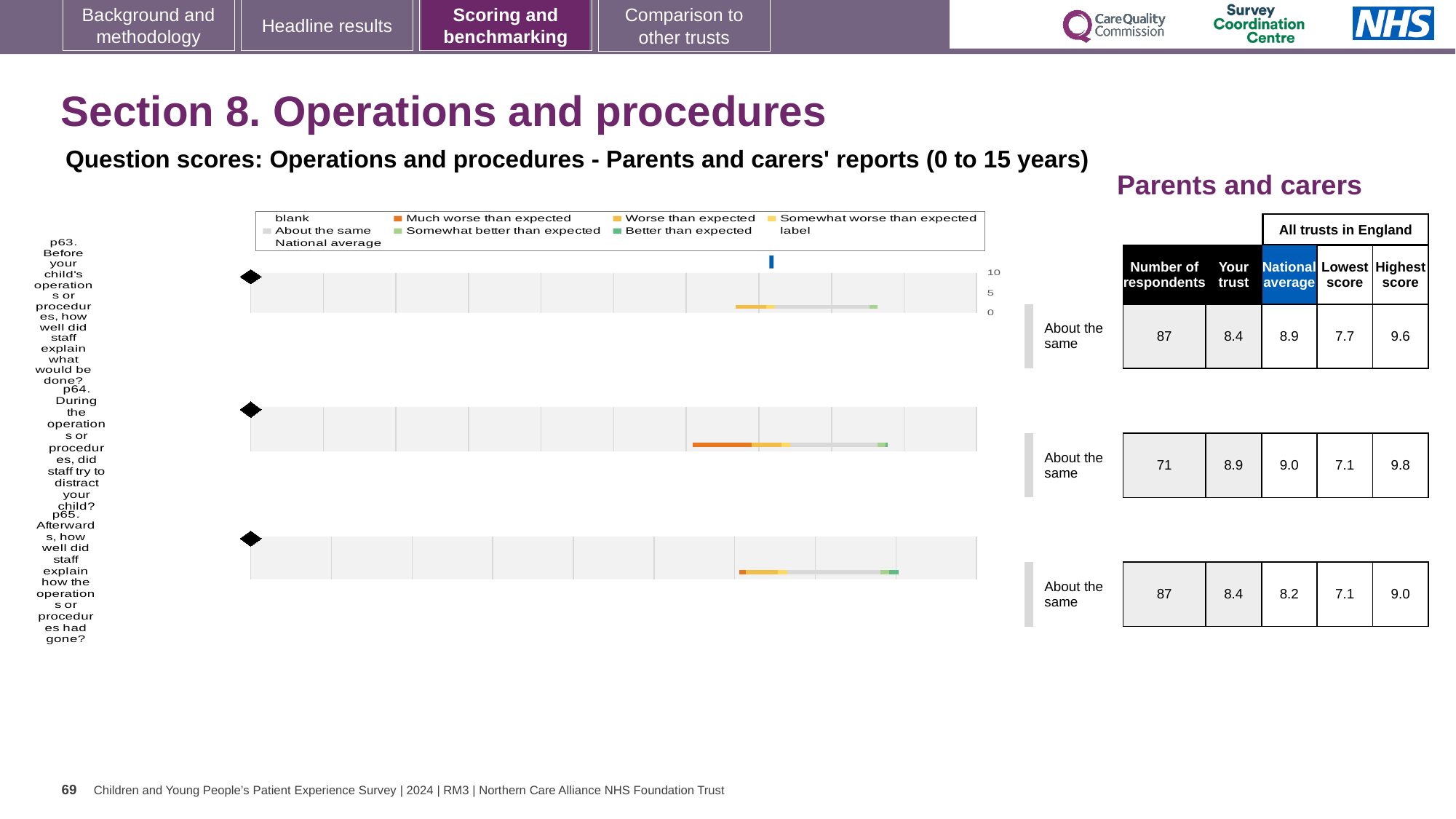
What is the difference between the highest score and the lowest score for p63? 1.9 What is the 'Your trust' score for p64 (During the operations or procedures, did staff try to distract your child?)? 8.9 How many respondents answered p64? 71 What is the national average score for p63 (Before your child's operations or procedures, how well did staff explain what would be done?)? 8.9 What benchmark category is shown for p63? About the same Which question has the highest 'Your trust' score? p64 What colour represents 'Much worse than expected' in the legend? Orange What kind of chart is used to show the question scores? Bar chart Is the 'Your trust' score for p63 greater or less than 5? greater For p65, which is larger: the 'Your trust' score or the national average? Your trust What is the highest score across all trusts in England for p65? 9.0 How many questions are plotted on the slide? 3